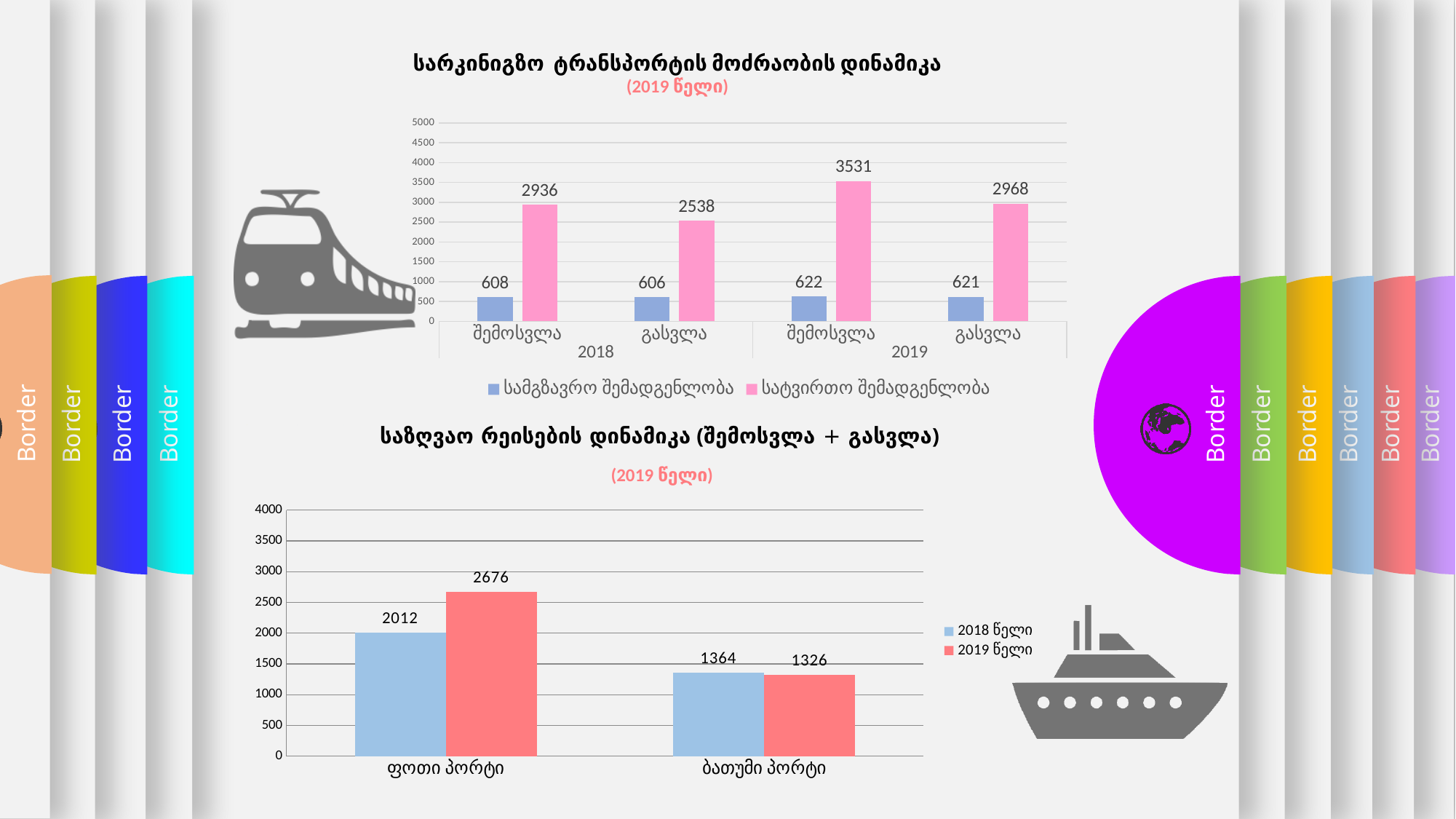
In the bottom chart (sea voyages), what is the 2018 წელი value for ბათუმი პორტი? 1364 In the top chart (railway transport), which series is shown in pink? სატვირთო შემადგენლობა In the top chart (railway transport), which category has the highest სატვირთო შემადგენლობა value? შემოსვლა 2019 In the top chart (railway transport), what is the value of სატვირთო შემადგენლობა for შემოსვლა in 2019? 3531 In the bottom chart (sea voyages), what is the 2019 წელი value for ფოთი პორტი? 2676 In the top chart (railway transport), how many series does the legend list? 2 In the top chart (railway transport), how many bars are plotted in total? 8 In the bottom chart (sea voyages), which is larger for ბათუმი პორტი: the 2018 წელი value or the 2019 წელი value? 2018 წელი In the bottom chart (sea voyages), what is the difference between the 2019 წელი and 2018 წელი values for ფოთი პორტი? 664 In the top chart (railway transport), what is the value of სამგზავრო შემადგენლობა for გასვლა in 2018? 606 What type of chart is the bottom chart (sea voyages)? Bar chart In the top chart (railway transport), what is the difference between the სატვირთო შემადგენლობა values for შემოსვლა in 2019 and შემოსვლა in 2018? 595